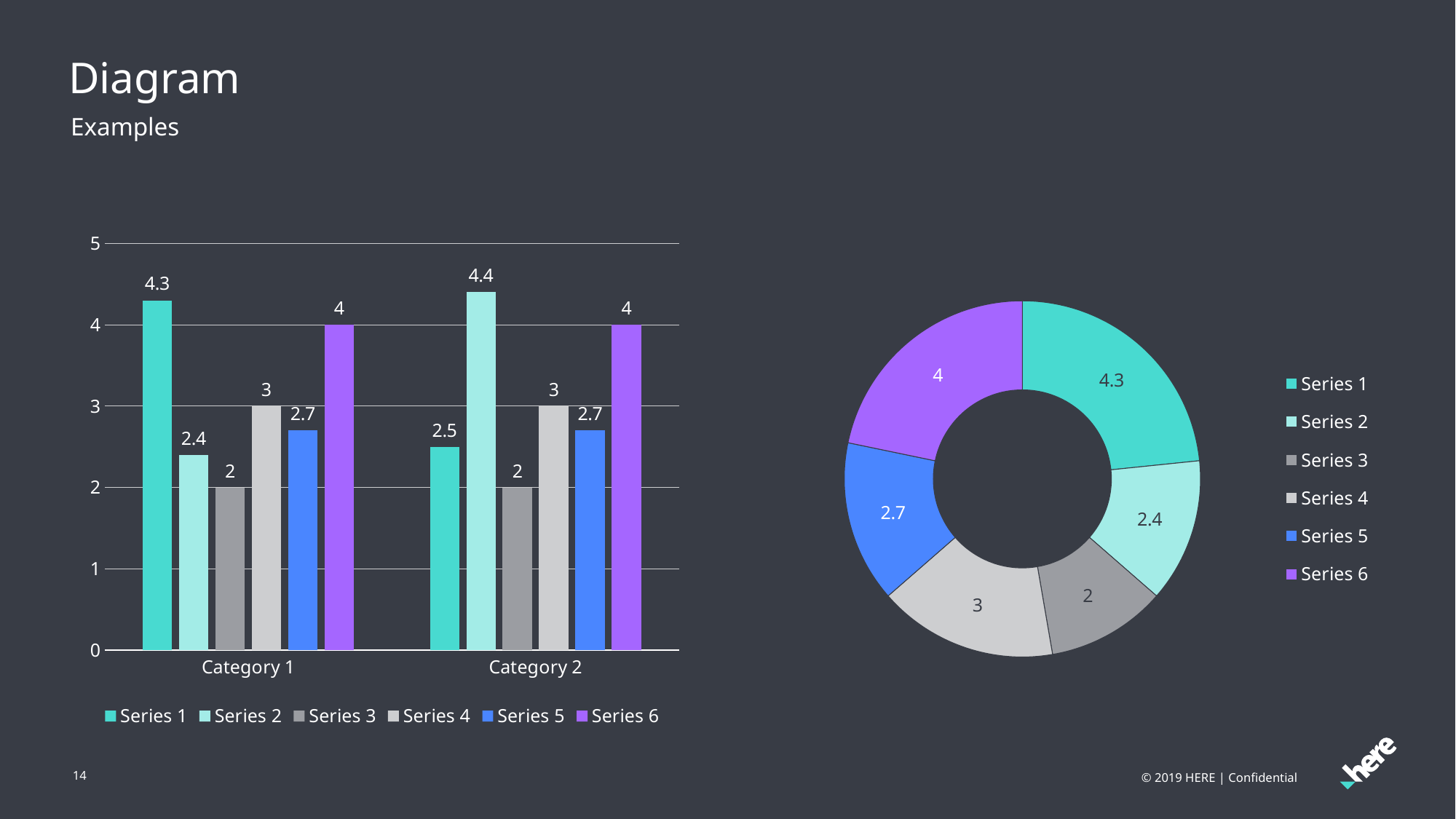
In the doughnut chart on the right, which series has the largest slice? Series 1 How many series does the legend of the bar chart on the left list? 6 In the bar chart on the left, what is the value of Series 1 in Category 2? 2.5 In the doughnut chart on the right, what is the total of all the slice values? 18.4 In the doughnut chart on the right, what is the value of the Series 5 slice? 2.7 In the bar chart on the left, what is the difference between Series 1 and Series 2 in Category 2? 1.9 How many categories are shown on the x axis of the bar chart on the left? 2 In the bar chart on the left, which series has the highest value in Category 1? Series 1 In the bar chart on the left, which series has the lowest value in Category 2? Series 3 In the bar chart on the left, what is the value of Series 5 in Category 1? 2.7 What kind of chart is shown on the left of the slide? Bar chart In the bar chart on the left, which is larger: Series 4 in Category 1 or Series 5 in Category 1? Series 4